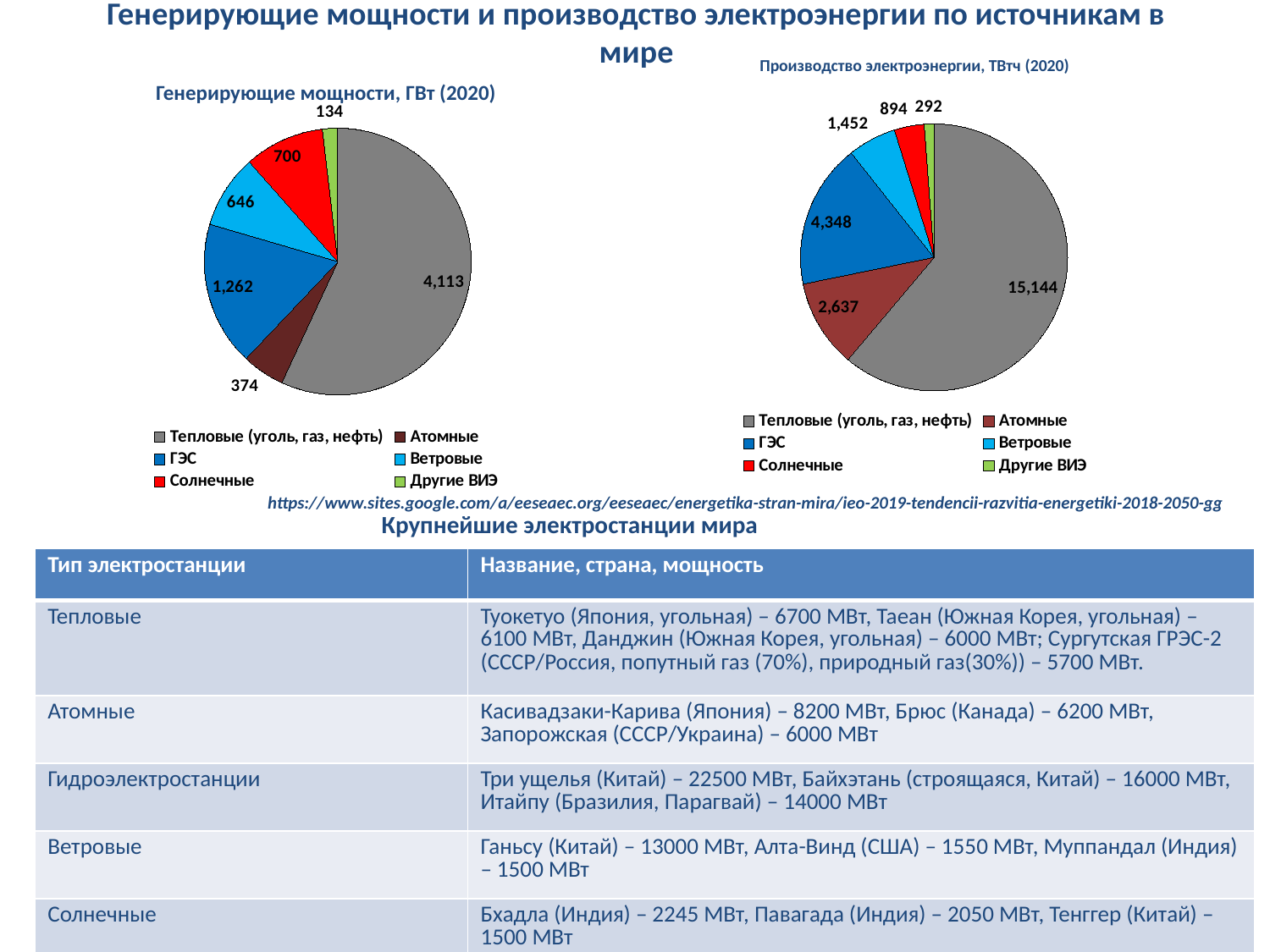
In the left pie chart (Генерирующие мощности, ГВт (2020)), what colour is the slice for Ветровые? Light blue In the right pie chart (Производство электроэнергии, ТВтч (2020)), what is the value for Атомные? 2,637 In the right pie chart (Производство электроэнергии, ТВтч (2020)), what is the value for Ветровые? 1,452 What type of chart is used for Генерирующие мощности, ГВт (2020)? Pie chart In the left pie chart (Генерирующие мощности, ГВт (2020)), which is larger: Солнечные or Атомные? Солнечные How many categories does the legend of the right pie chart (Производство электроэнергии, ТВтч (2020)) list? 6 In the right pie chart (Производство электроэнергии, ТВтч (2020)), what is the difference between the values for ГЭС and Атомные? 1,711 In the left pie chart (Генерирующие мощности, ГВт (2020)), what is the difference between the values for Солнечные and Ветровые? 54 In the left pie chart (Генерирующие мощности, ГВт (2020)), what is the value for ГЭС? 1,262 In the left pie chart (Генерирующие мощности, ГВт (2020)), which category has the smallest slice? Другие ВИЭ In the left pie chart (Генерирующие мощности, ГВт (2020)), what is the value for Тепловые (уголь, газ, нефть)? 4,113 In the right pie chart (Производство электроэнергии, ТВтч (2020)), which category has the largest slice? Тепловые (уголь, газ, нефть)